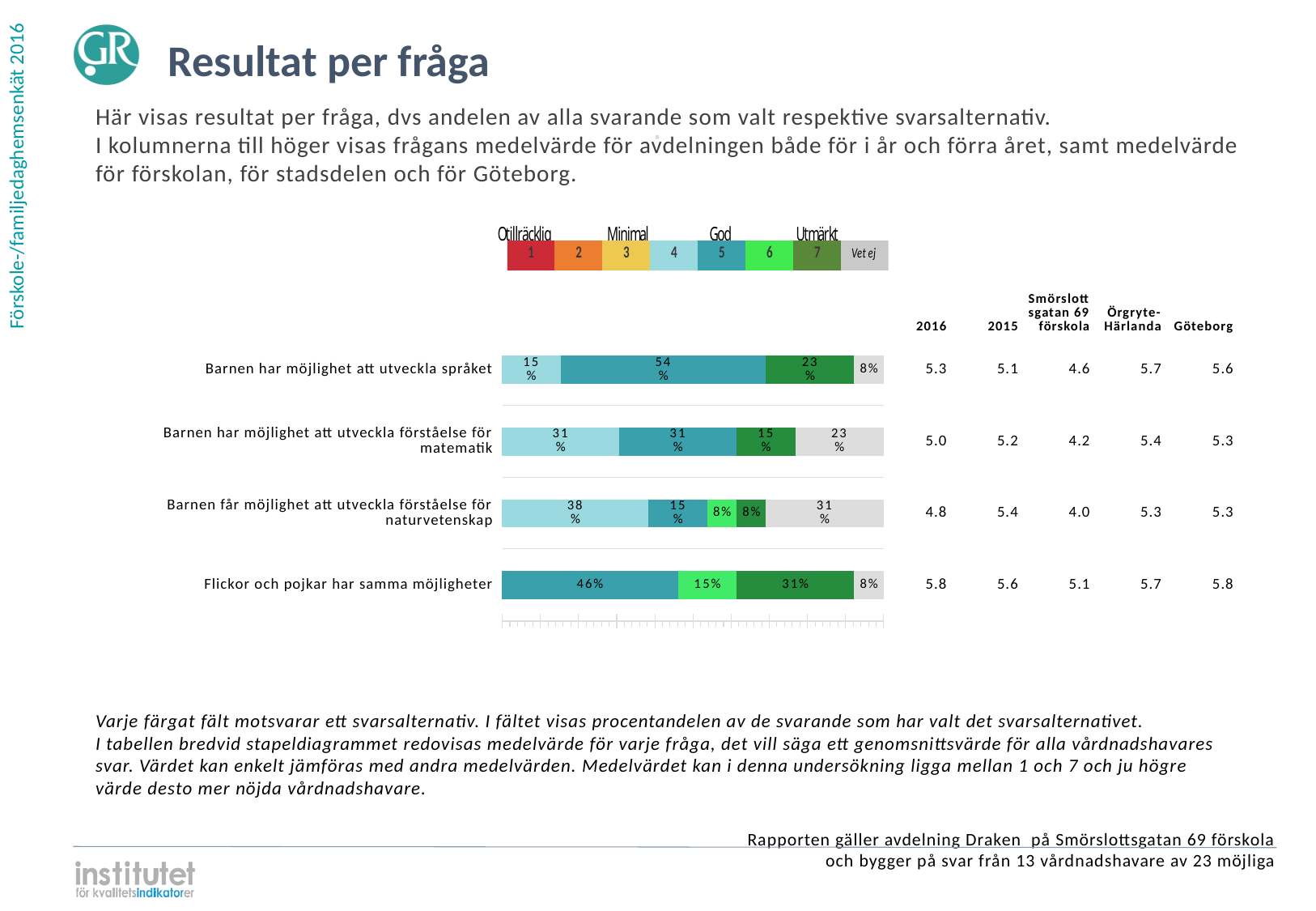
Which is larger: the largest segment for 'Barnen har möjlighet att utveckla språket' or the largest segment for 'Flickor och pojkar har samma möjligheter'? Barnen har möjlighet att utveckla språket What label does the legend give to answer option 7? Utmärkt What is the grey 'Vet ej' share for 'Barnen har möjlighet att utveckla förståelse för matematik'? 23% What is the largest percentage segment in the bar for 'Flickor och pojkar har samma möjligheter'? 46% What is the grey 'Vet ej' share for 'Barnen får möjlighet att utveckla förståelse för naturvetenskap'? 31% What kind of chart is shown on the slide? Stacked bar chart What is the total of all segments in the bar for 'Barnen har möjlighet att utveckla förståelse för matematik'? 100% What is the largest percentage segment in the bar for 'Barnen har möjlighet att utveckla språket'? 54% Which question has the highest grey 'Vet ej' share? Barnen får möjlighet att utveckla förståelse för naturvetenskap What is the difference between the 'Vet ej' share for naturvetenskap (31%) and for språket (8%)? 23% How many questions (categories) are plotted in the bar chart? 4 How many answer options does the legend above the chart list, including 'Vet ej'? 8